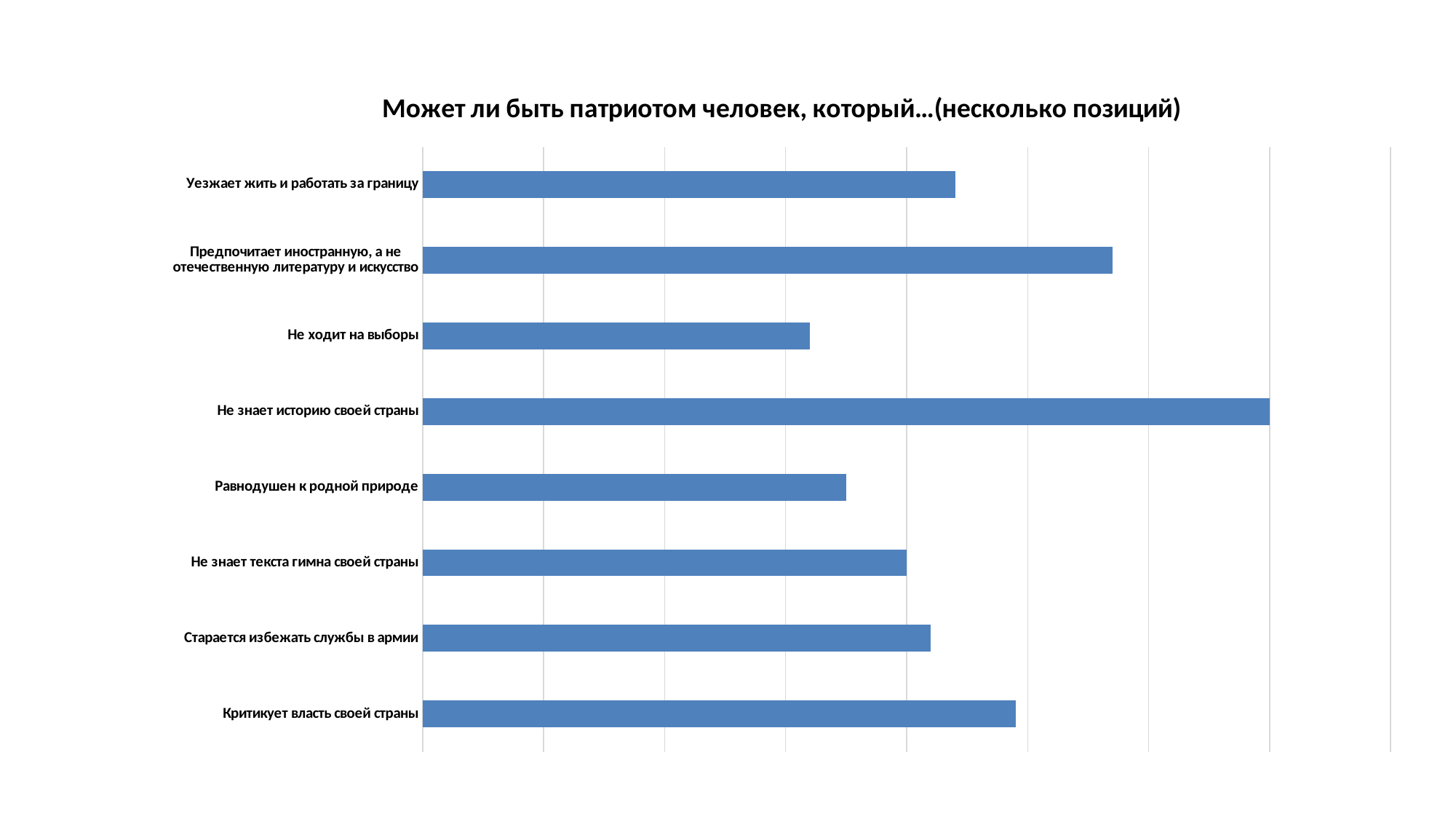
Which bar is longer: "Не знает историю своей страны" or "Не ходит на выборы"? Не знает историю своей страны What is the title of the chart? Может ли быть патриотом человек, который…(несколько позиций) Which category is listed at the top of the chart? Уезжает жить и работать за границу Which category has the longest bar? Не знает историю своей страны Which bar is longer: "Критикует власть своей страны" or "Уезжает жить и работать за границу"? Критикует власть своей страны Which category has the shortest bar? Не ходит на выборы Which bar is longer: "Предпочитает иностранную, а не отечественную литературу и искусство" or "Критикует власть своей страны"? Предпочитает иностранную, а не отечественную литературу и искусство What kind of chart is shown on the slide? Bar chart How many categories are plotted in the chart? 8